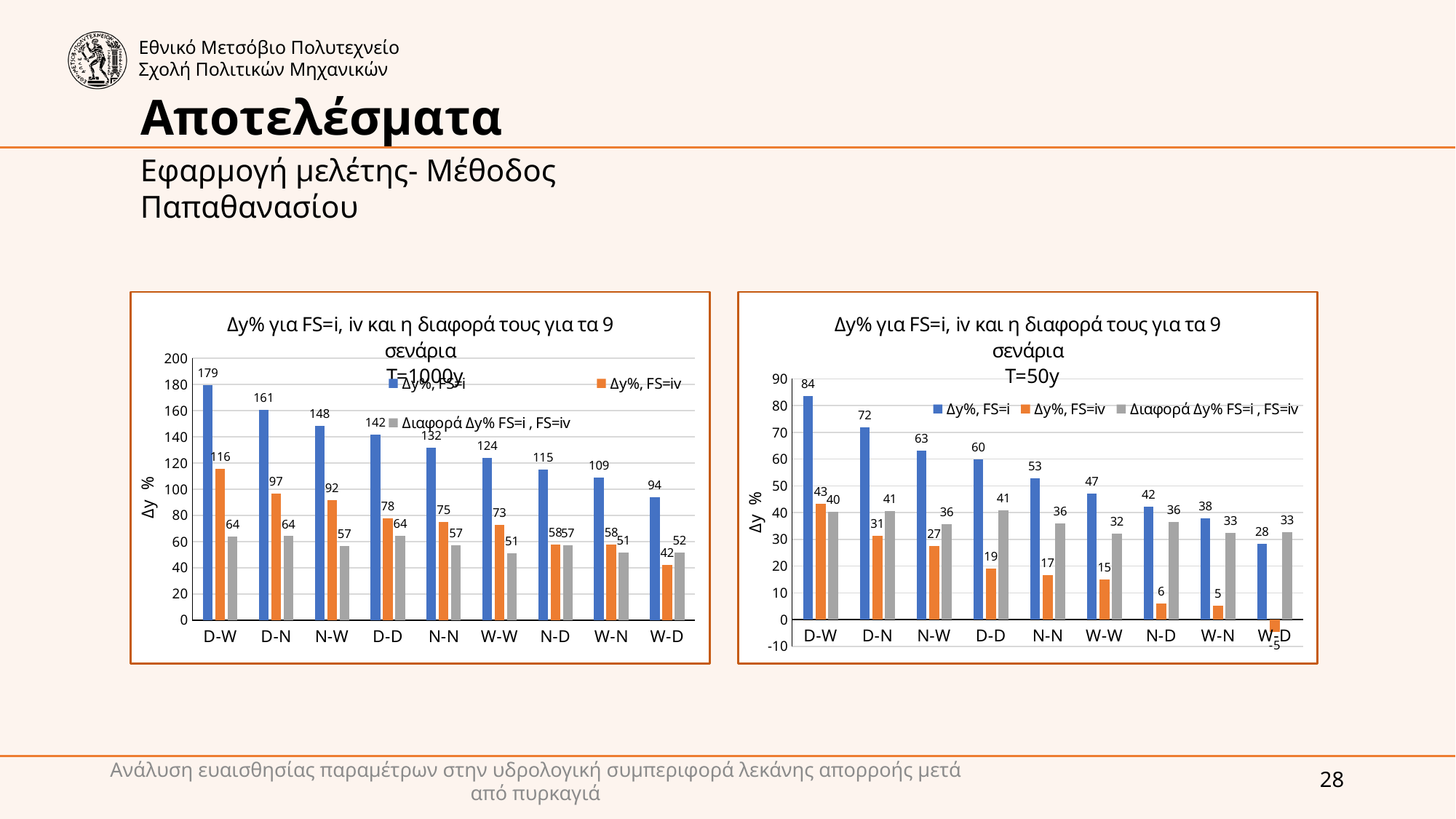
In the right chart (T=50y), which is larger for N-N: Δy%, FS=i or Διαφορά Δy% FS=i , FS=iv? Δy%, FS=i In the right chart (T=50y), do the values of Δy%, FS=i rise or fall from D-W to W-D? Fall How many categories are shown on the x axis of the left chart (T=1000y)? 9 What type of chart is the right chart (T=50y)? Bar chart In the right chart (T=50y), what is the value of Διαφορά Δy% FS=i , FS=iv for D-N? 41 In the left chart (T=1000y), what is the value of Δy%, FS=iv for W-D? 42 In the left chart (T=1000y), what is the difference between Δy%, FS=i and Δy%, FS=iv for D-N? 64 In the right chart (T=50y), what is the value of Δy%, FS=iv for W-D? -5 In the right chart (T=50y), which category has the highest value of Δy%, FS=i? D-W In the left chart (T=1000y), which category has the lowest value of Δy%, FS=iv? W-D In the left chart (T=1000y), what is the value of Δy%, FS=i for D-W? 179 How many series does the legend of the right chart (T=50y) list? 3